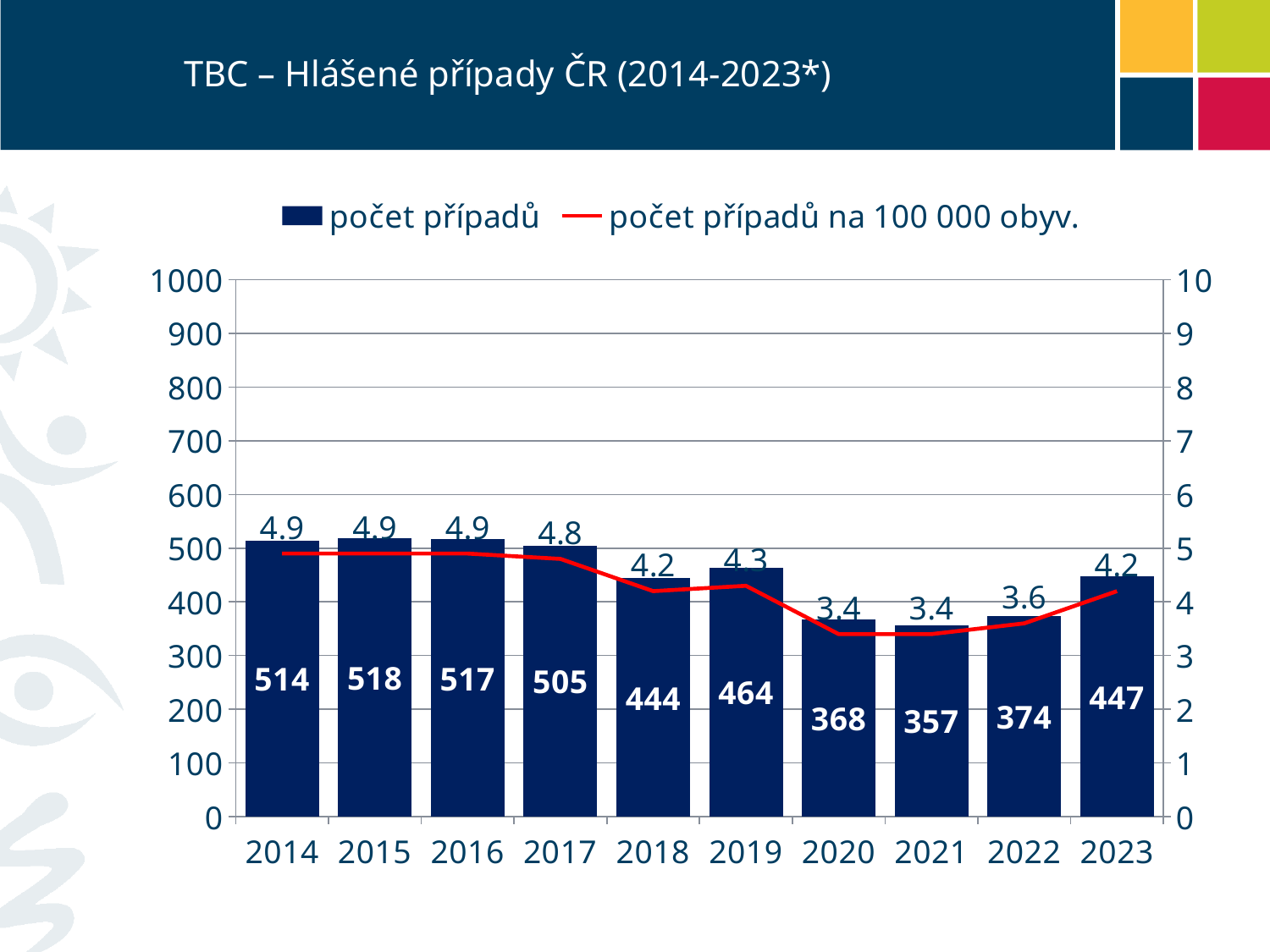
How many years are shown on the x axis? 10 What is the value of "počet případů na 100 000 obyv." for 2017? 4.8 Which year has the lowest value of "počet případů"? 2021 Which year has the highest value of "počet případů"? 2015 How many series does the legend list? 2 Is the value of "počet případů" for 2022 greater or less than 400? less What kind of chart is shown on the slide? Combined bar and line chart What is the title of the slide? TBC – Hlášené případy ČR (2014-2023*) What is the value of "počet případů" for 2021? 357 What is the difference in "počet případů" between 2019 and 2020? 96 Which year has the larger value of "počet případů": 2018 or 2023? 2023 What is the value of "počet případů" for 2014? 514